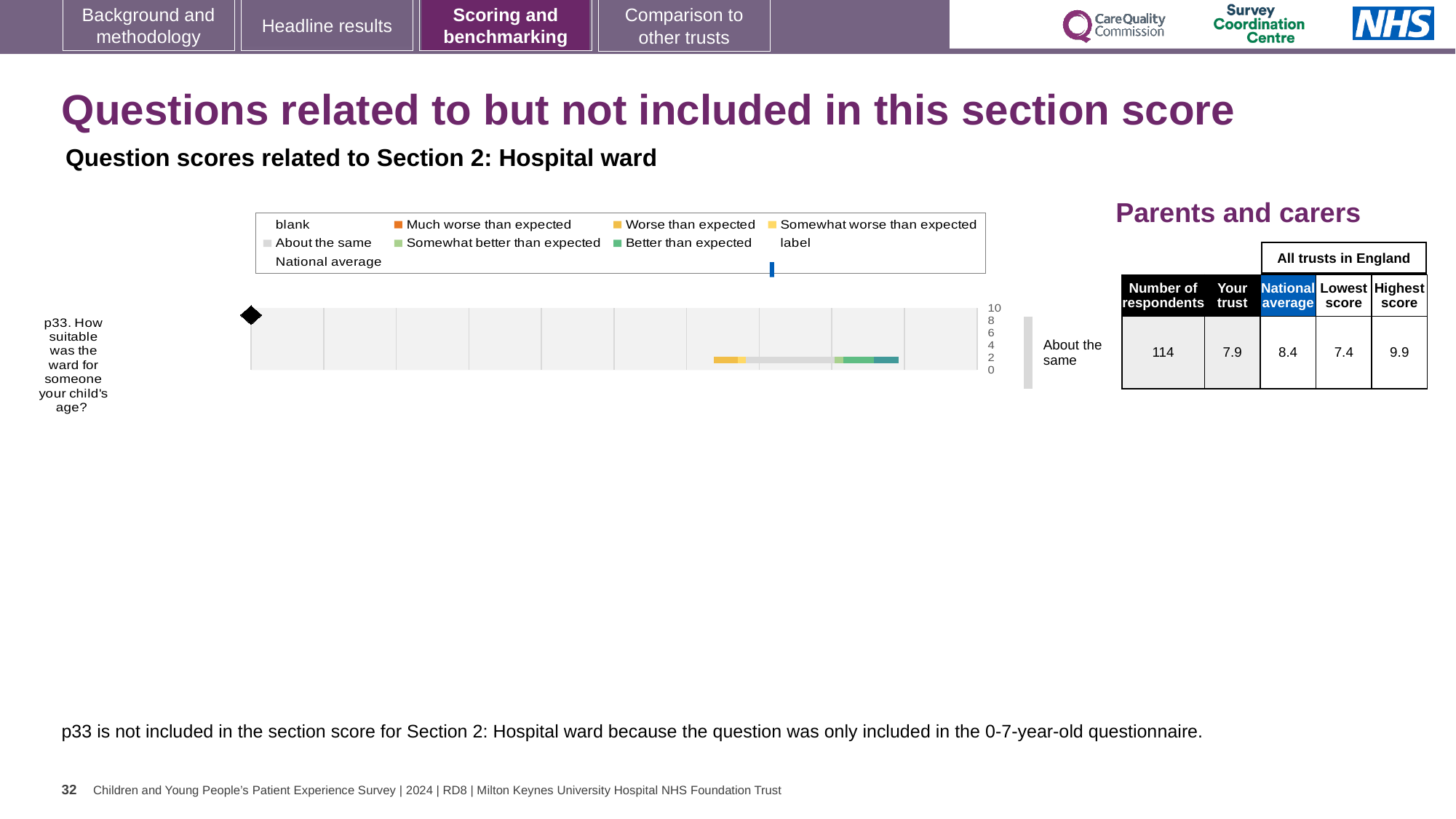
What is the highest score across all trusts in England for p33? 9.9 What is the difference between the national average (8.4) and the 'Your trust' score (7.9) for p33? 0.5 Which colour in the legend represents 'Much worse than expected'? Orange What is the national average score for p33? 8.4 Which is larger for p33: the 'Your trust' score or the national average? National average How many questions are plotted in the chart? 1 What is the difference between the highest score (9.9) and the lowest score (7.4) for p33? 2.5 How many respondents answered p33? 114 What is the lowest score across all trusts in England for p33? 7.4 What benchmark category label is shown next to the bar for p33? About the same What is the 'Your trust' score for p33 (How suitable was the ward for someone your child's age?)? 7.9 What kind of chart is shown for question p33? bar chart